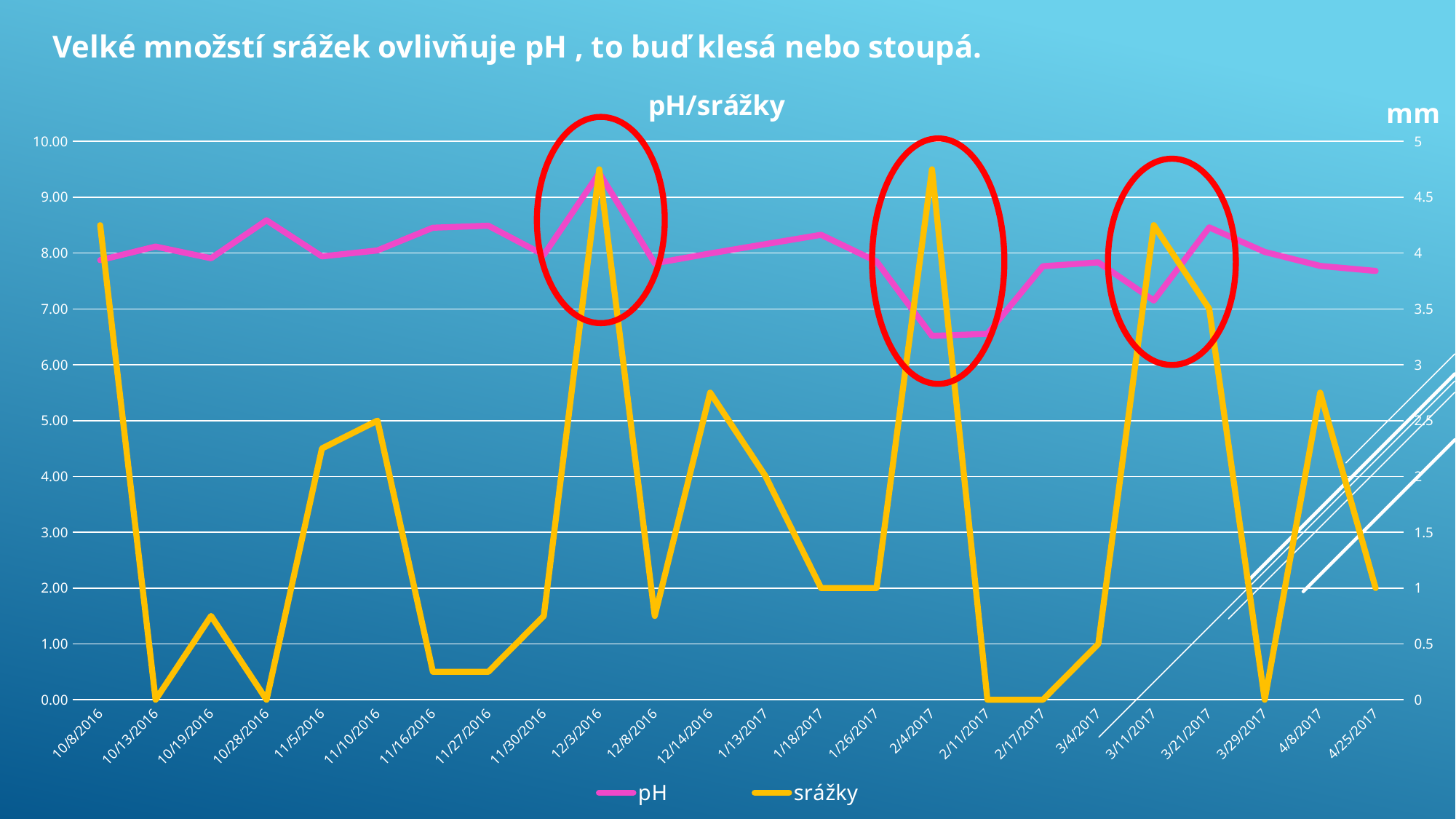
Which is larger, the pH value on 10/28/2016 or on 11/5/2016? 10/28/2016 How many series does the legend list? 2 Is the pH value on 2/4/2017 greater or less than 7.00? less What unit label is shown above the right-hand axis? mm Is the pH value on 10/28/2016 greater or less than 8.00? greater On which date does the pH series reach its highest value? 12/3/2016 How many dates are plotted along the x axis? 24 What is the srážky value on 2/11/2017? 0 What kind of chart is shown on the slide? line chart What is the title of the chart? pH/srážky What is the srážky value on 10/13/2016? 0 Does the pH series rise or fall between 1/18/2017 and 2/4/2017? fall